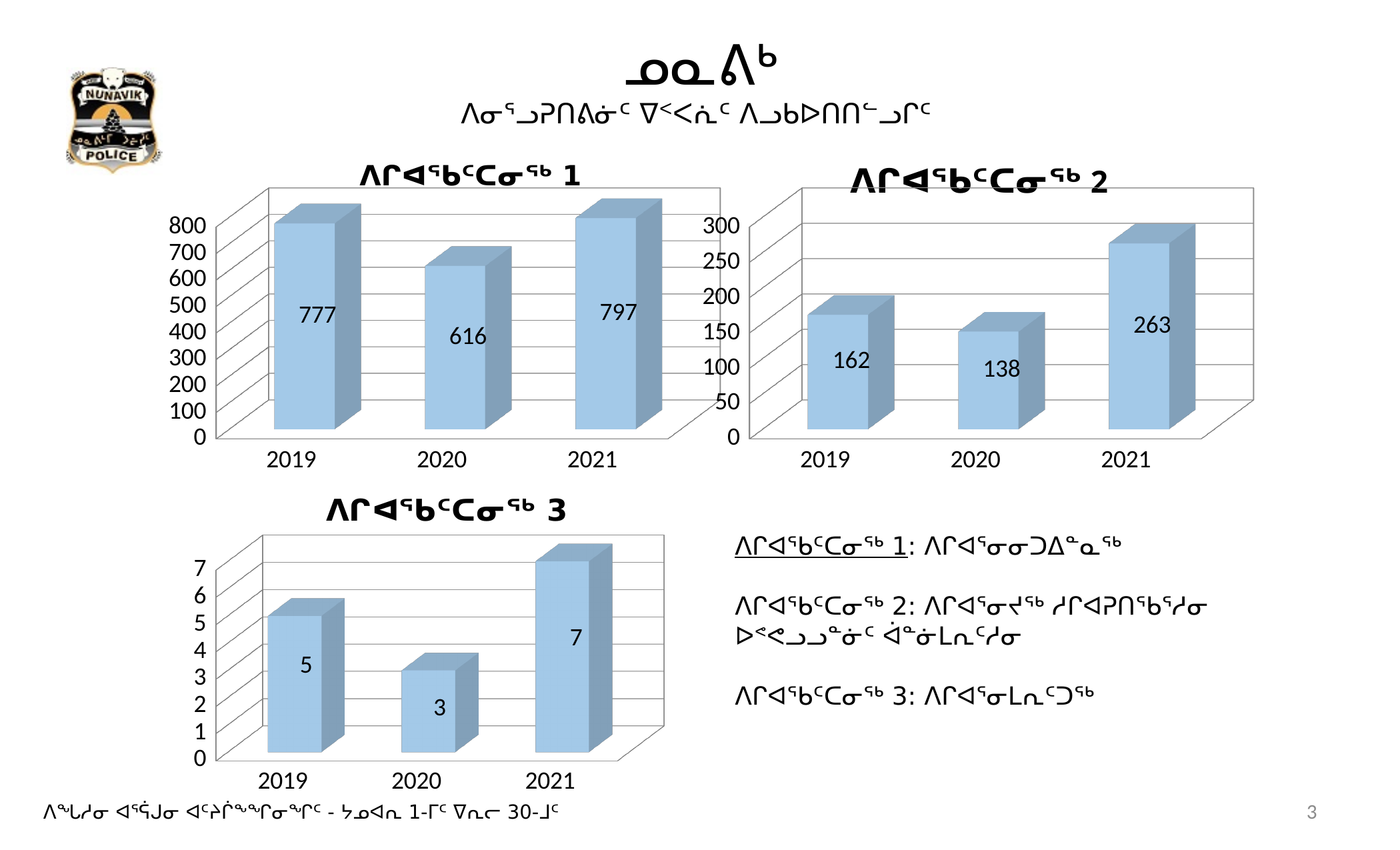
How many charts are on the slide? 3 In the top-right chart, which year has the highest value? 2021 In the top-right chart, is the value for 2019 larger or smaller than the value for 2020? larger In the top-left chart, what is the difference between the 2021 and 2020 values? 181 In the bottom-left chart, what is the value for 2020? 3 In the top-right chart, what is the difference between the 2019 and 2020 values? 24 In the top-left chart, which year has the lowest value? 2020 How many years are shown on the x axis of the bottom-left chart? 3 What kind of chart is the top-left chart? bar chart In the top-right chart, what is the value for 2021? 263 In the top-left chart, what is the value for 2019? 777 In the bottom-left chart, which year has the highest value? 2021